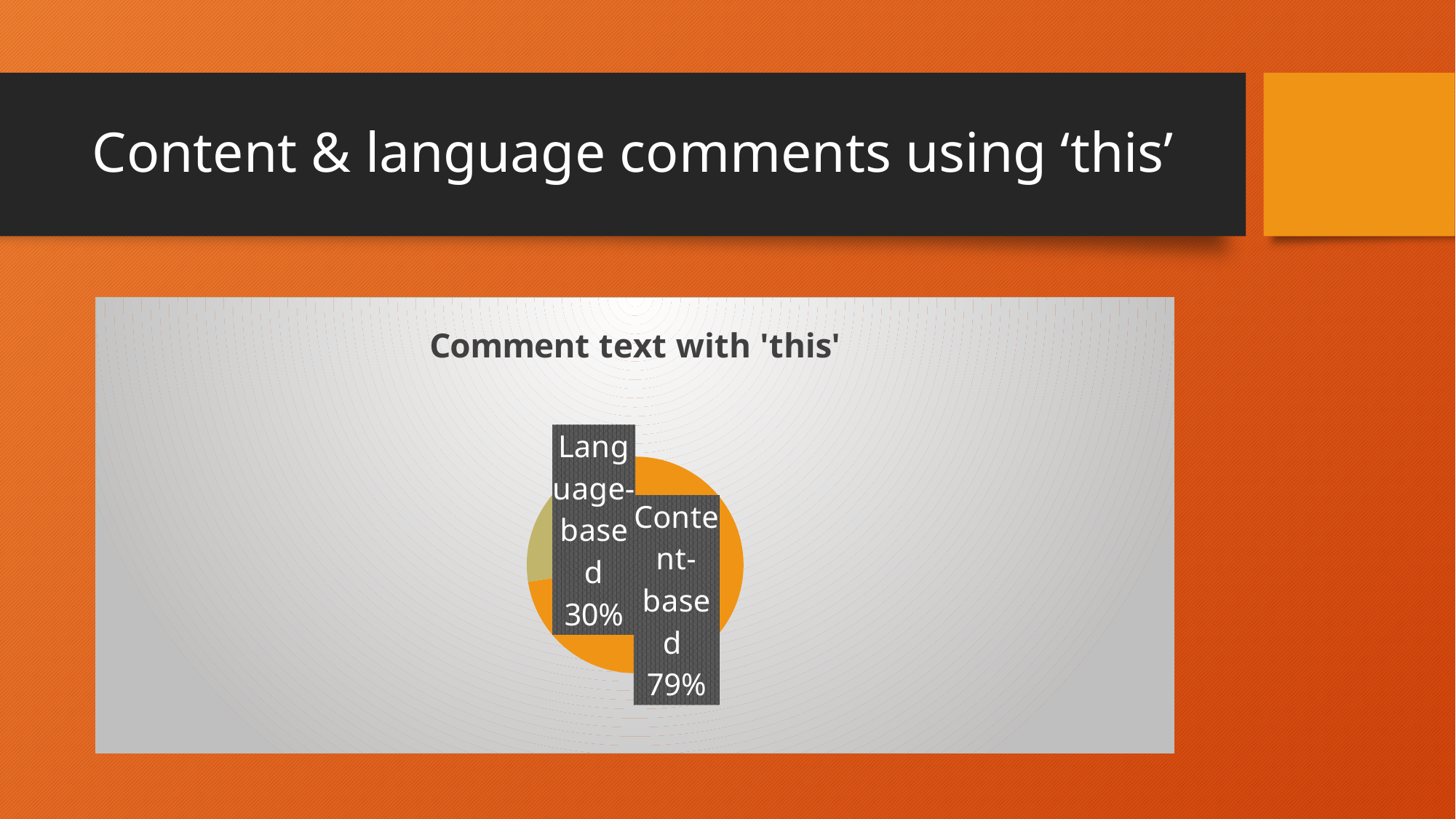
What is the title of the chart? Comment text with 'this' Which is larger, the Content-based slice or the Language-based slice? Content-based Is the Language-based share greater or less than 50%? less What kind of chart is shown on the slide? pie chart What share of the pie does the Content-based slice represent? 79% Which slice of the pie is the smallest? Language-based How many slices does the pie chart have? 2 Which slice of the pie is the largest? Content-based Is the Content-based share greater or less than 50%? greater What percentage of the pie is Content-based? 79% What percentage of the pie is Language-based? 30%